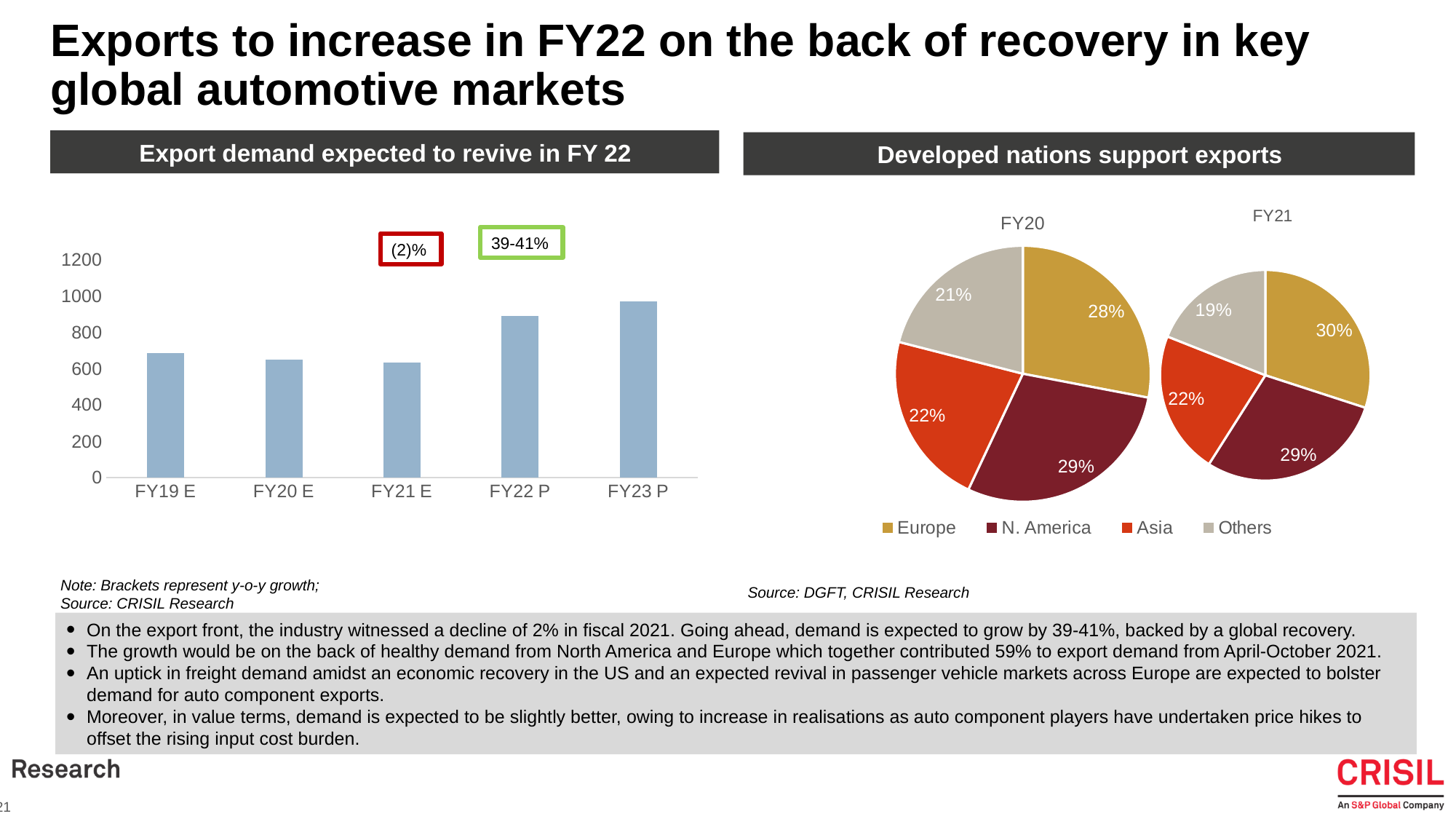
In the 'Export demand expected to revive in FY 22' bar chart, how many fiscal-year categories are plotted? 5 In the 'Export demand expected to revive in FY 22' bar chart, which fiscal year has the tallest bar? FY23 P In the FY21 pie chart under 'Developed nations support exports', how many percentage points larger is Europe's share than Others' share? 11 percentage points In the 'Export demand expected to revive in FY 22' bar chart, what y-o-y growth is shown in the bracket above FY21 E? (2)% In the 'Export demand expected to revive in FY 22' bar chart, is the value for FY19 E greater or less than 800? less In the FY20 pie chart under 'Developed nations support exports', what share does Europe hold? 28% In the FY21 pie chart under 'Developed nations support exports', which region has the largest share? Europe In the FY21 pie chart under 'Developed nations support exports', what share does Others hold? 19% In the 'Export demand expected to revive in FY 22' bar chart, is the value for FY22 P greater or less than 800? greater How many regions does the legend of the pie charts under 'Developed nations support exports' list? 4 What kind of chart is shown under the heading 'Export demand expected to revive in FY 22'? Bar chart In the FY20 pie chart under 'Developed nations support exports', which region has the smallest share? Others